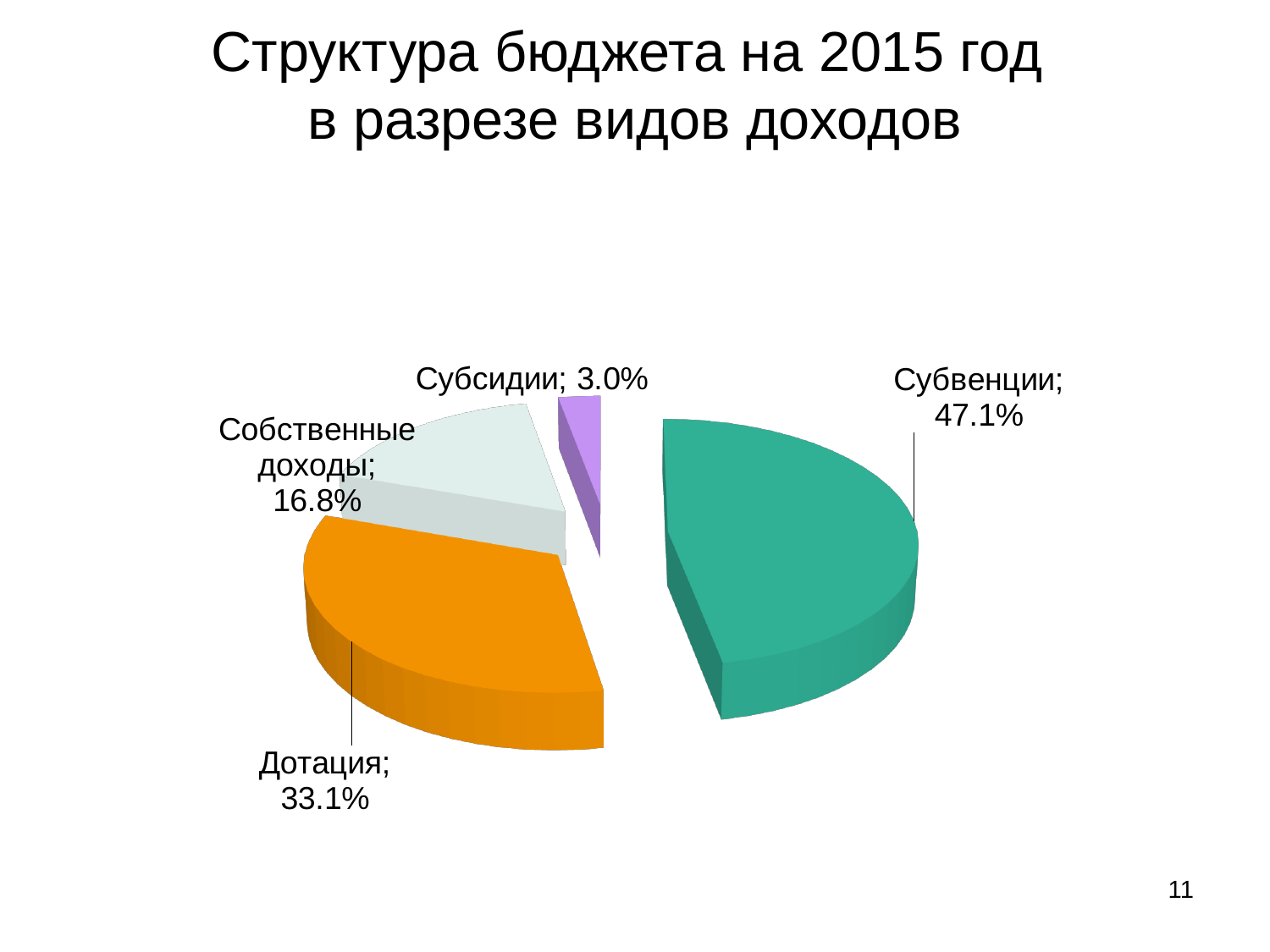
Which is larger, Дотация or Собственные доходы? Дотация How many slices does the pie chart have? 4 What share of the pie does Собственные доходы have? 16.8% What share of the pie does Субсидии have? 3.0% What share of the pie does Дотация have? 33.1% What share of the pie does Субвенции have? 47.1% What kind of chart is shown on the slide? Pie chart Which category has the largest share of the pie? Субвенции What is the difference in percentage points between Собственные доходы and Субсидии? 13.8 What is the title of the chart on the slide? Структура бюджета на 2015 год в разрезе видов доходов What is the difference in percentage points between Субвенции and Дотация? 14.0 Which category has the smallest share of the pie? Субсидии